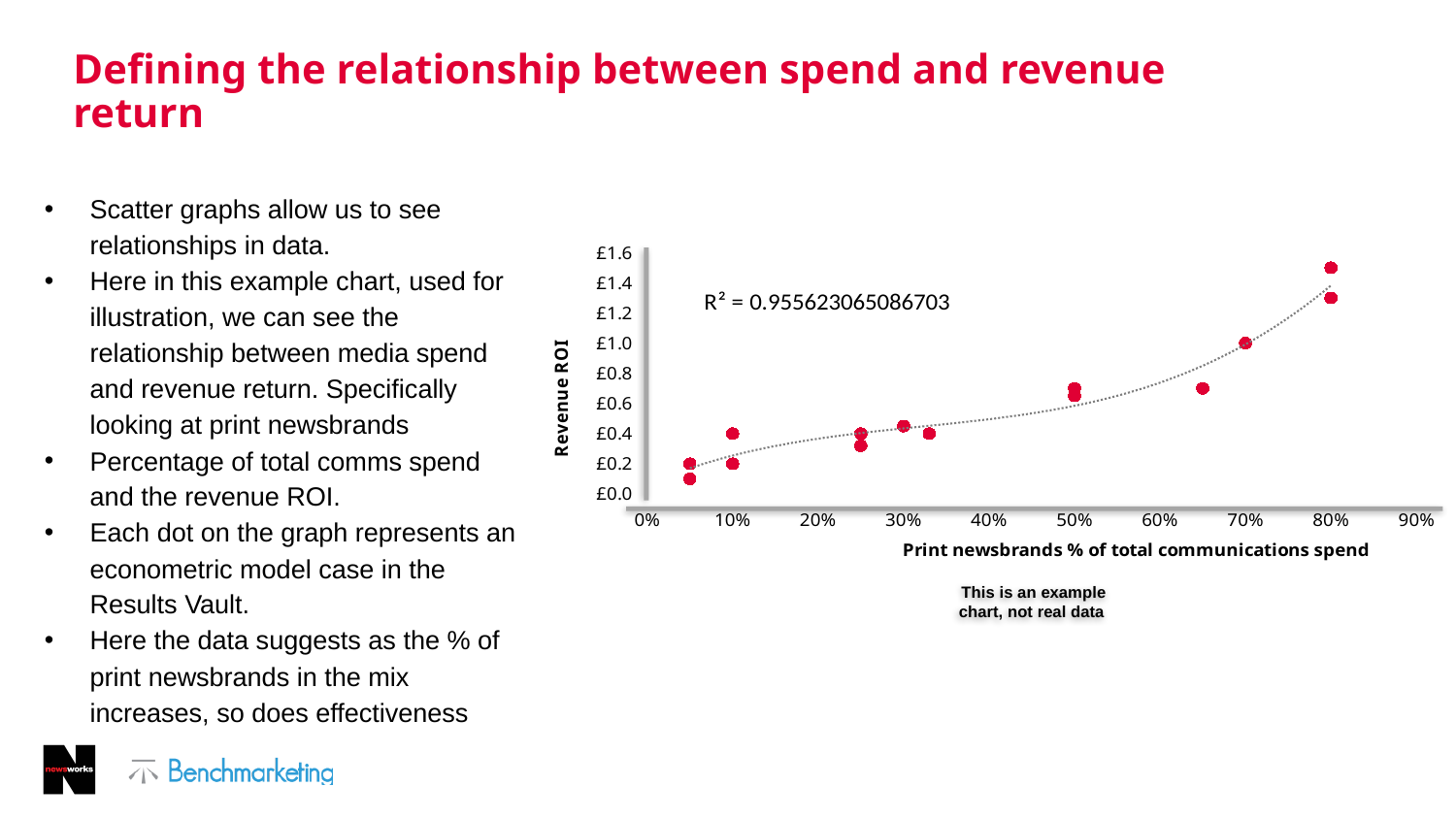
As the print newsbrands % of total communications spend increases along the x axis, does Revenue ROI generally rise or fall? Rise Is the Revenue ROI for the points at 80% print newsbrands spend greater or less than £1.0? greater What kind of chart is shown on the slide? Scatter chart What R² value is printed on the chart? R² = 0.955623065086703 What is the title of the x axis of the chart? Print newsbrands % of total communications spend Is the Revenue ROI for the point at 70% print newsbrands spend greater or less than £0.6? greater Is the Revenue ROI for the point at 30% print newsbrands spend greater or less than £0.2? greater At which print newsbrands spend percentage does the highest Revenue ROI point appear? 80% Which has the higher Revenue ROI: the points at 80% print newsbrands spend or the points at 10%? 80% Which has the higher Revenue ROI: the points at 50% print newsbrands spend or the point at 30%? 50%